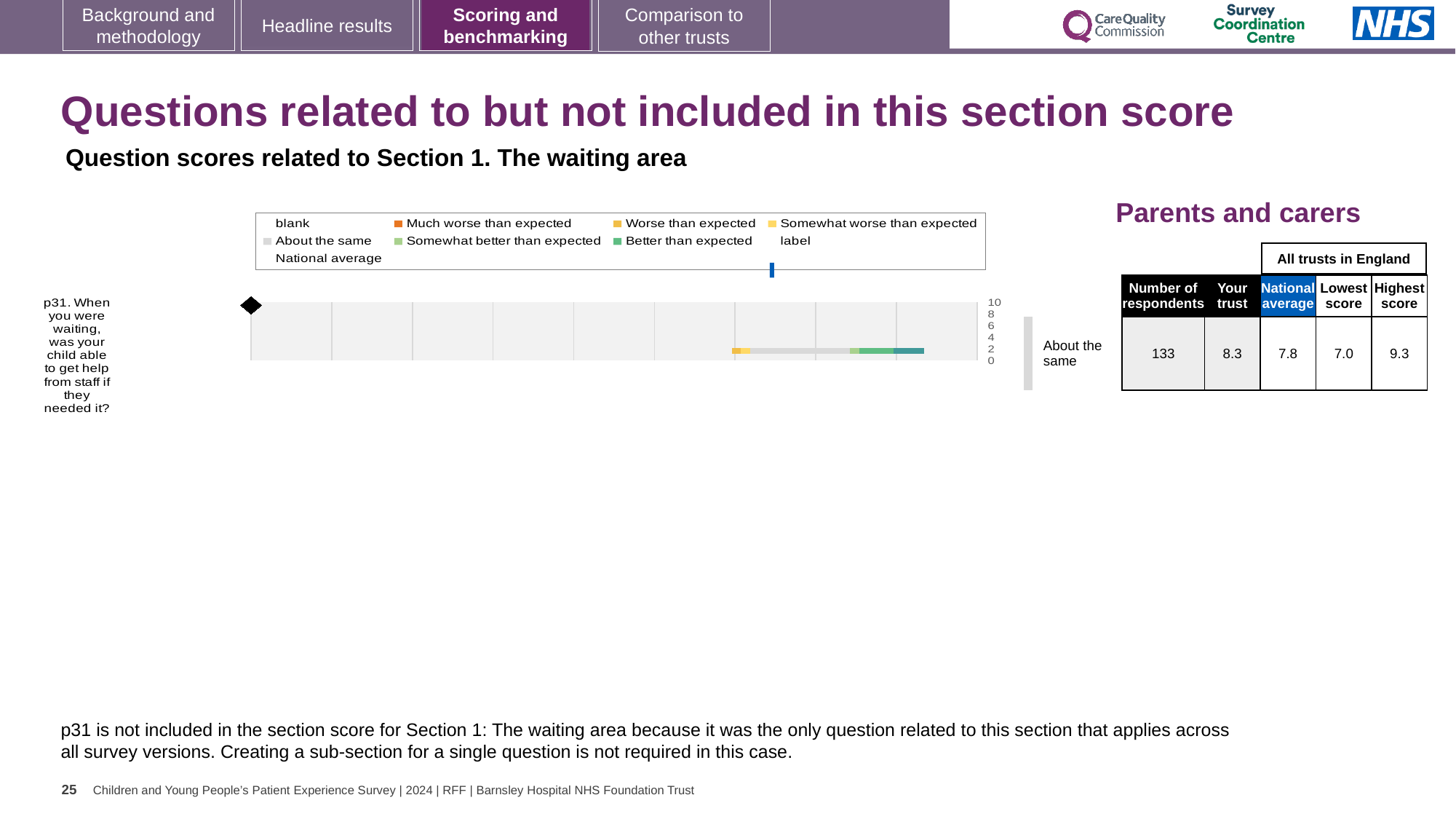
What is the maximum value shown on the chart's score axis? 10 How many questions are plotted in the chart? 1 In the table beside the chart, what is the 'Your trust' score for p31? 8.3 What is the difference between the highest score and the lowest score for p31 in the table beside the chart? 2.3 For p31, which is higher: the 'Your trust' score or the national average? Your trust In the table beside the chart, what is the highest score among all trusts in England for p31? 9.3 In the table beside the chart, what is the lowest score among all trusts in England for p31? 7.0 What kind of chart is used to show the p31 question score? bar chart Which question number is plotted in the chart? p31 What benchmark category label is shown to the right of the p31 bar? About the same In the table beside the chart, what is the national average score for p31? 7.8 How many respondents answered p31 according to the table beside the chart? 133